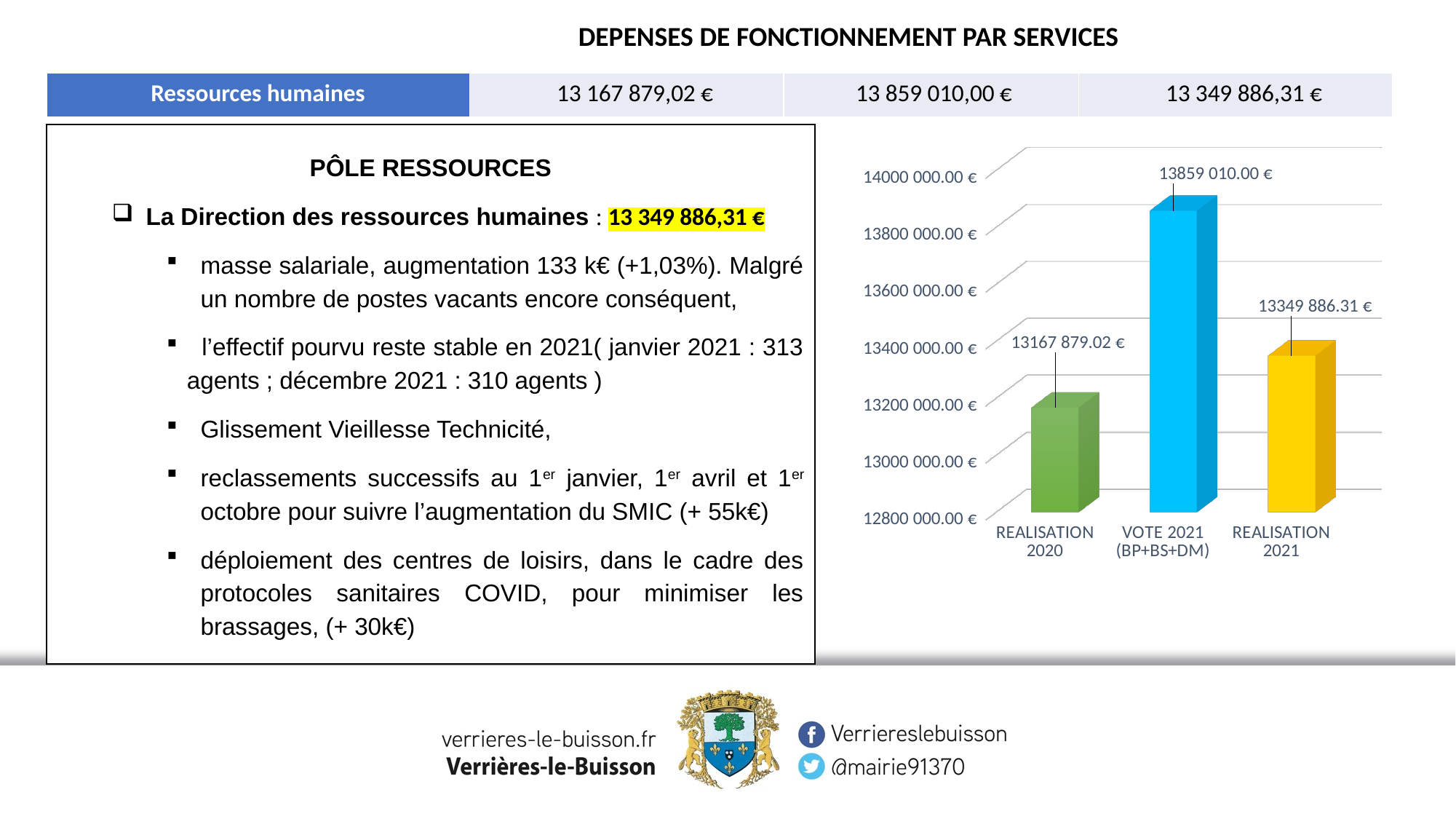
What is the difference between the VOTE 2021 (BP+BS+DM) value and the REALISATION 2021 value? 509 123.69 € Which category has the highest value in the chart? VOTE 2021 (BP+BS+DM) What is the value for VOTE 2021 (BP+BS+DM) in the chart? 13859 010.00 € What kind of chart is shown on the slide? bar chart What is the value for REALISATION 2021 in the chart? 13349 886.31 € Which category has the lowest value in the chart? REALISATION 2020 Which is larger, the value for REALISATION 2020 or the value for REALISATION 2021? REALISATION 2021 What colour is the bar for VOTE 2021 (BP+BS+DM)? blue What is the difference between the REALISATION 2021 value and the REALISATION 2020 value? 182 007.29 € Is the value for REALISATION 2021 greater or less than 13600 000.00 €? less How many bars are plotted in the chart? 3 What is the value for REALISATION 2020 in the chart? 13167 879.02 €